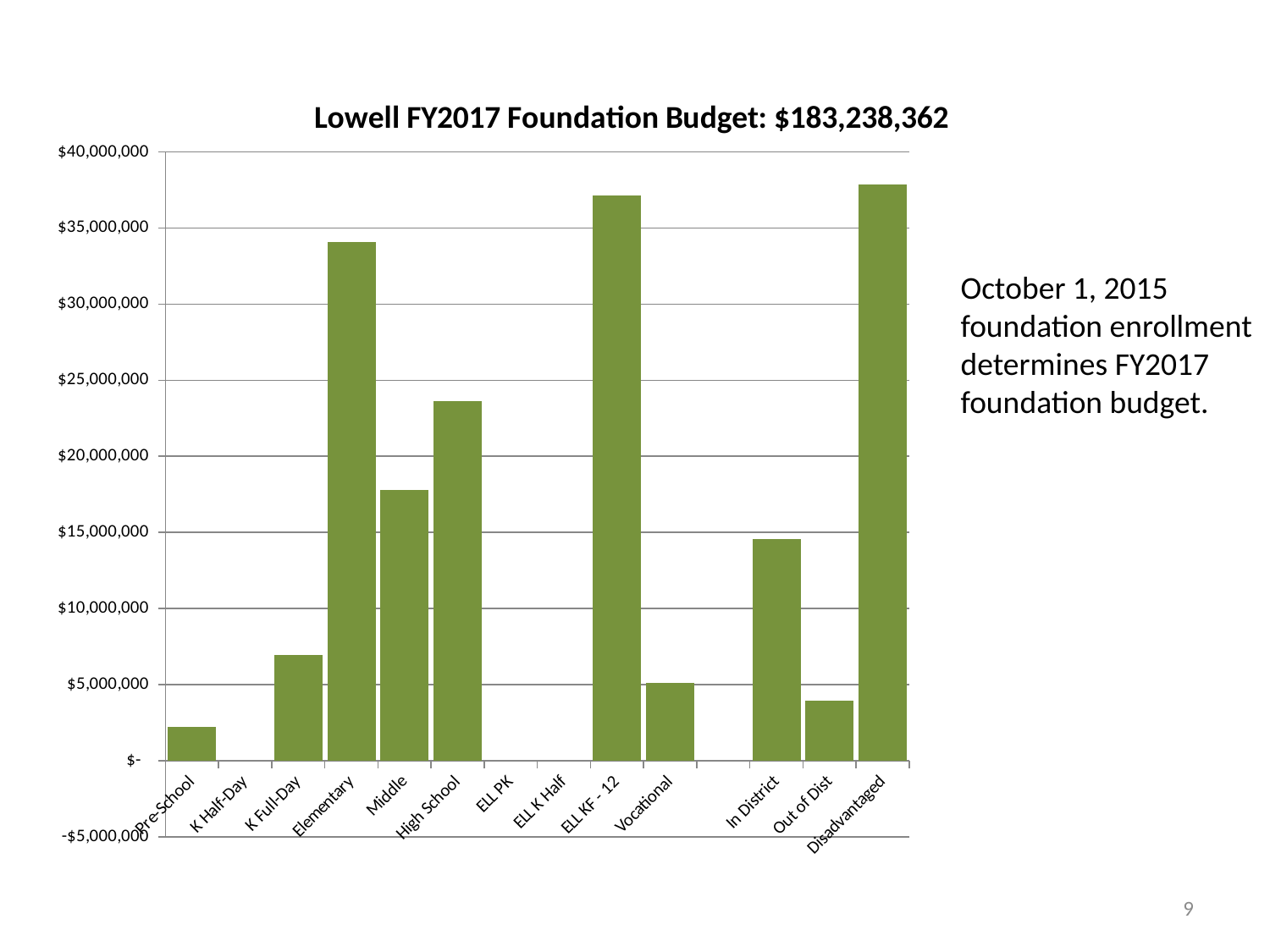
Is the value for Elementary greater or less than $30,000,000? greater Is the value for Out of Dist greater or less than $5,000,000? less Is the value for High School greater or less than $20,000,000? greater What is the title of the chart? Lowell FY2017 Foundation Budget: $183,238,362 What total foundation budget amount is stated in the chart title? $183,238,362 Which has a larger value, Middle or Vocational? Middle What kind of chart is shown on the slide? bar chart Which has a larger value, Elementary or High School? Elementary Which has a larger value, In District or Out of Dist? In District